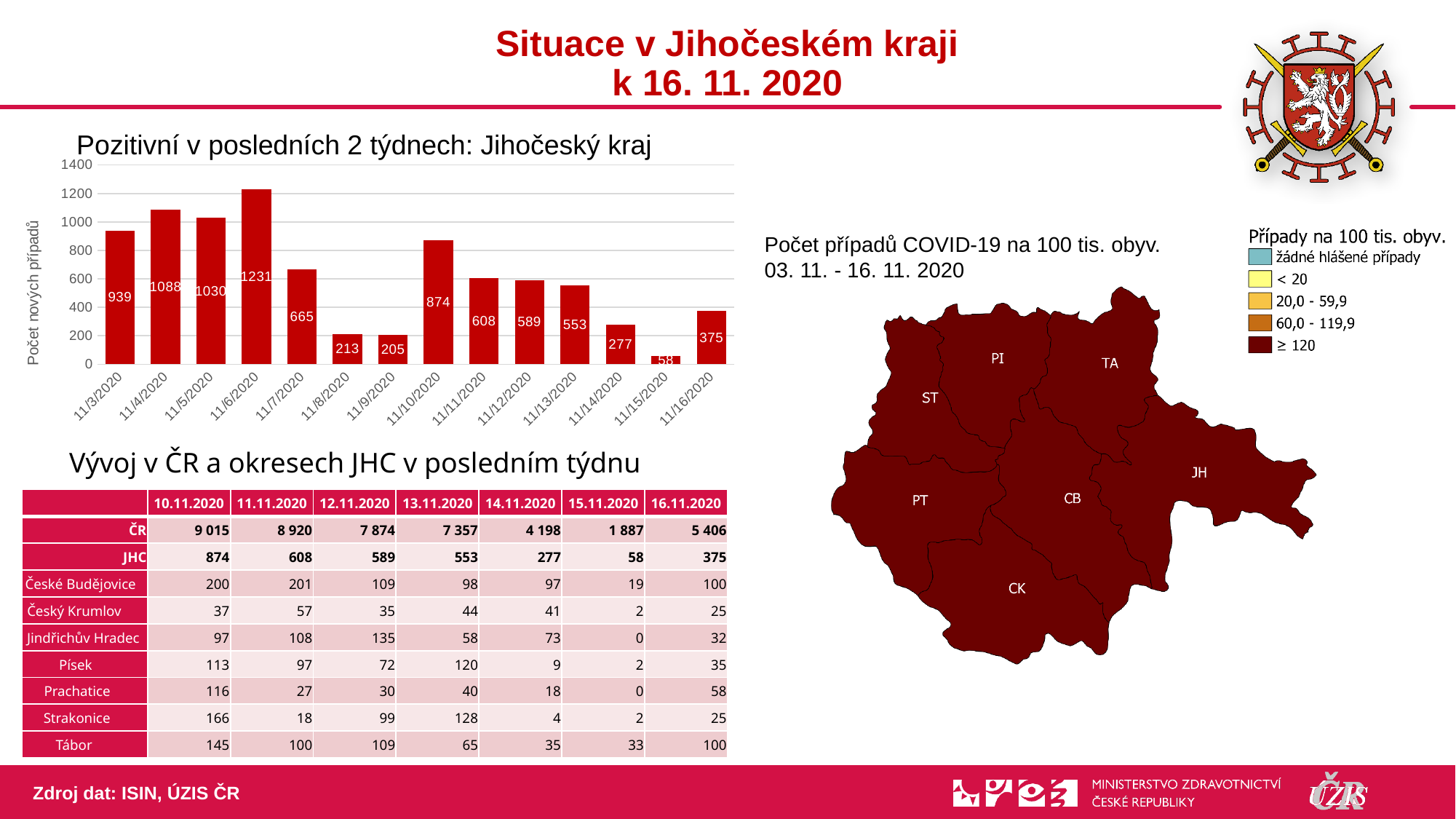
What is the value for 11/15/2020 in the bar chart? 58 Which is larger, the value for 11/8/2020 or the value for 11/9/2020? 11/8/2020 What is the value for 11/10/2020 in the bar chart? 874 What is the value for 11/6/2020 in the bar chart? 1231 What kind of chart is used to show the positive cases in the last 2 weeks? bar chart What is the difference between the values for 11/16/2020 and 11/14/2020? 98 What is the difference between the values for 11/4/2020 and 11/5/2020? 58 Which date has the lowest value in the bar chart? 11/15/2020 What is the title of the bar chart? Pozitivní v posledních 2 týdnech: Jihočeský kraj Which date has the highest value in the bar chart? 11/6/2020 How many dates are shown on the x axis of the bar chart? 14 Is the value for 11/3/2020 greater or less than 800? greater